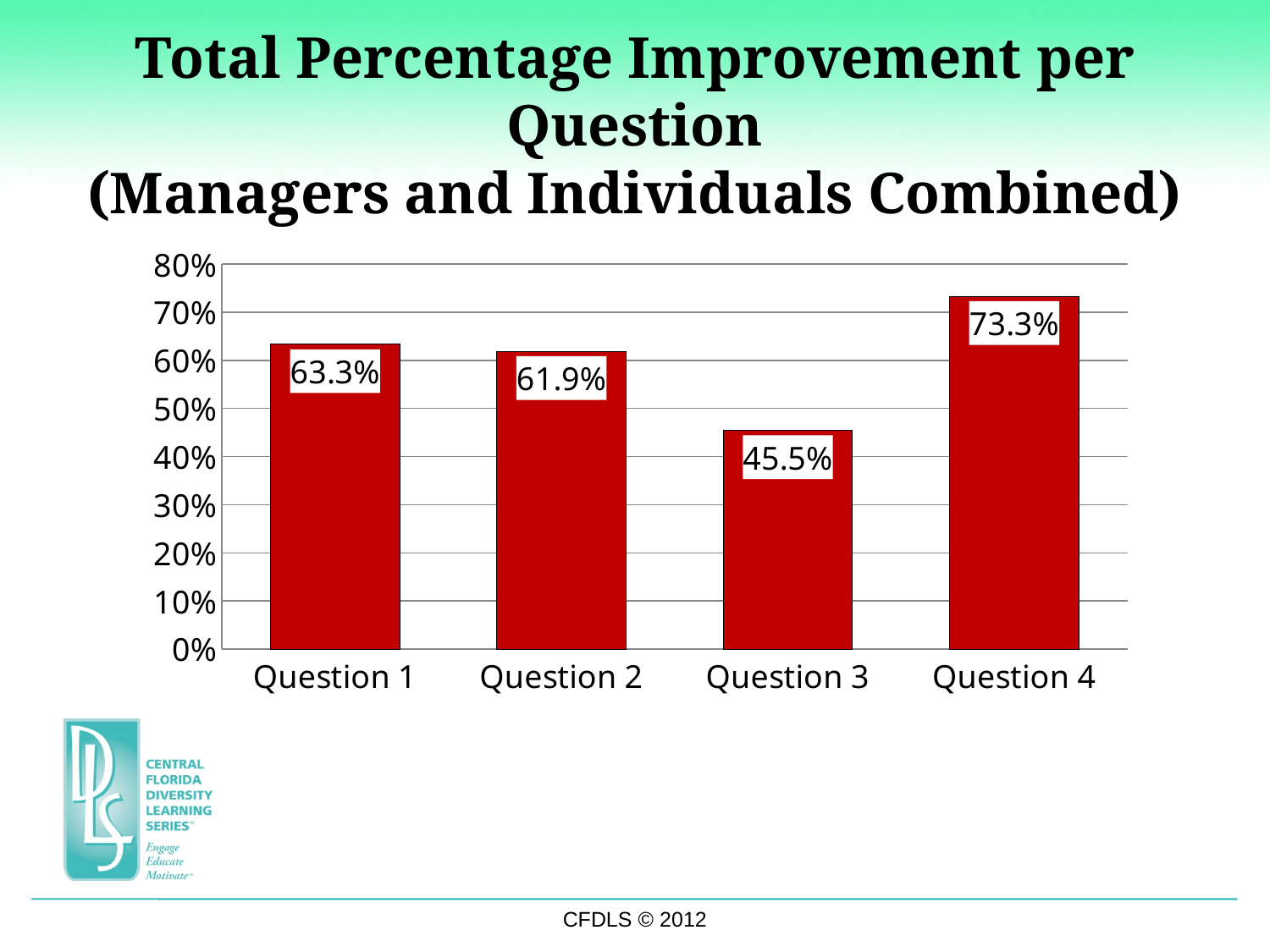
Which question has the highest percentage improvement? Question 4 What is the difference between the values for Question 1 and Question 2? 1.4% What kind of chart is shown on the slide? Bar chart What is the difference between the values for Question 4 and Question 3? 27.8% What is the value for Question 3? 45.5% What is the value for Question 4? 73.3% Is the value for Question 4 greater or less than 70%? greater Which is larger, the value for Question 2 or the value for Question 3? Question 2 What is the value for Question 1? 63.3% Which question has the lowest percentage improvement? Question 3 What is the title of the chart on the slide? Total Percentage Improvement per Question (Managers and Individuals Combined) How many questions are shown on the x axis? 4